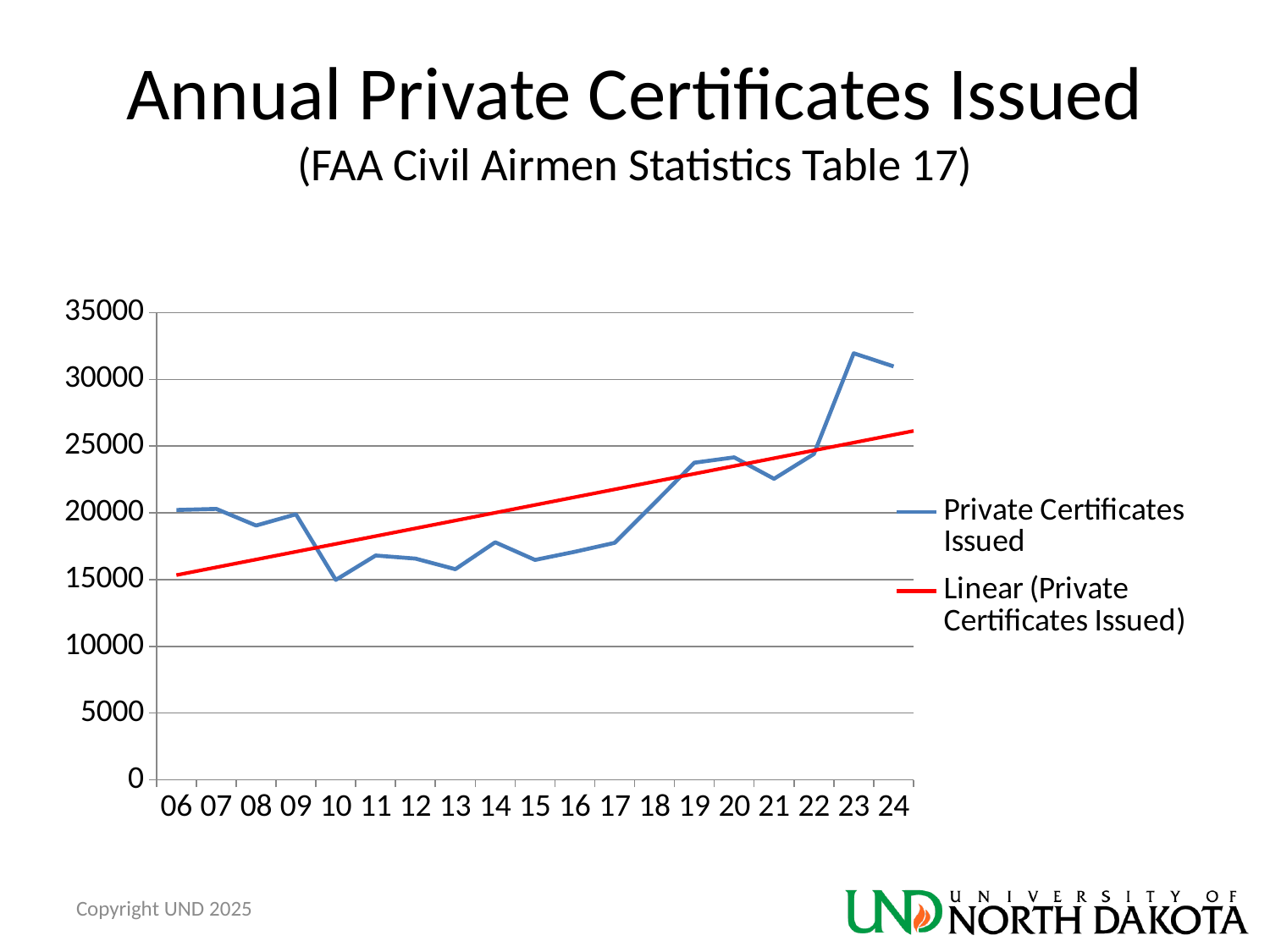
Is the value for Private Certificates Issued in 19 greater or less than 20000? greater What colour is the line for Private Certificates Issued? blue What kind of chart is shown on the slide? line chart How many years are plotted along the x axis? 19 Is the value for Private Certificates Issued in 23 greater or less than 30000? greater Which year has the lowest value for Private Certificates Issued? 10 Does the linear trend line rise or fall from 06 to 24? rise Is the value for Private Certificates Issued in 10 greater or less than 20000? less Which year has the highest value for Private Certificates Issued? 23 How many series does the legend list? 2 Which year has the larger value for Private Certificates Issued, 19 or 13? 19